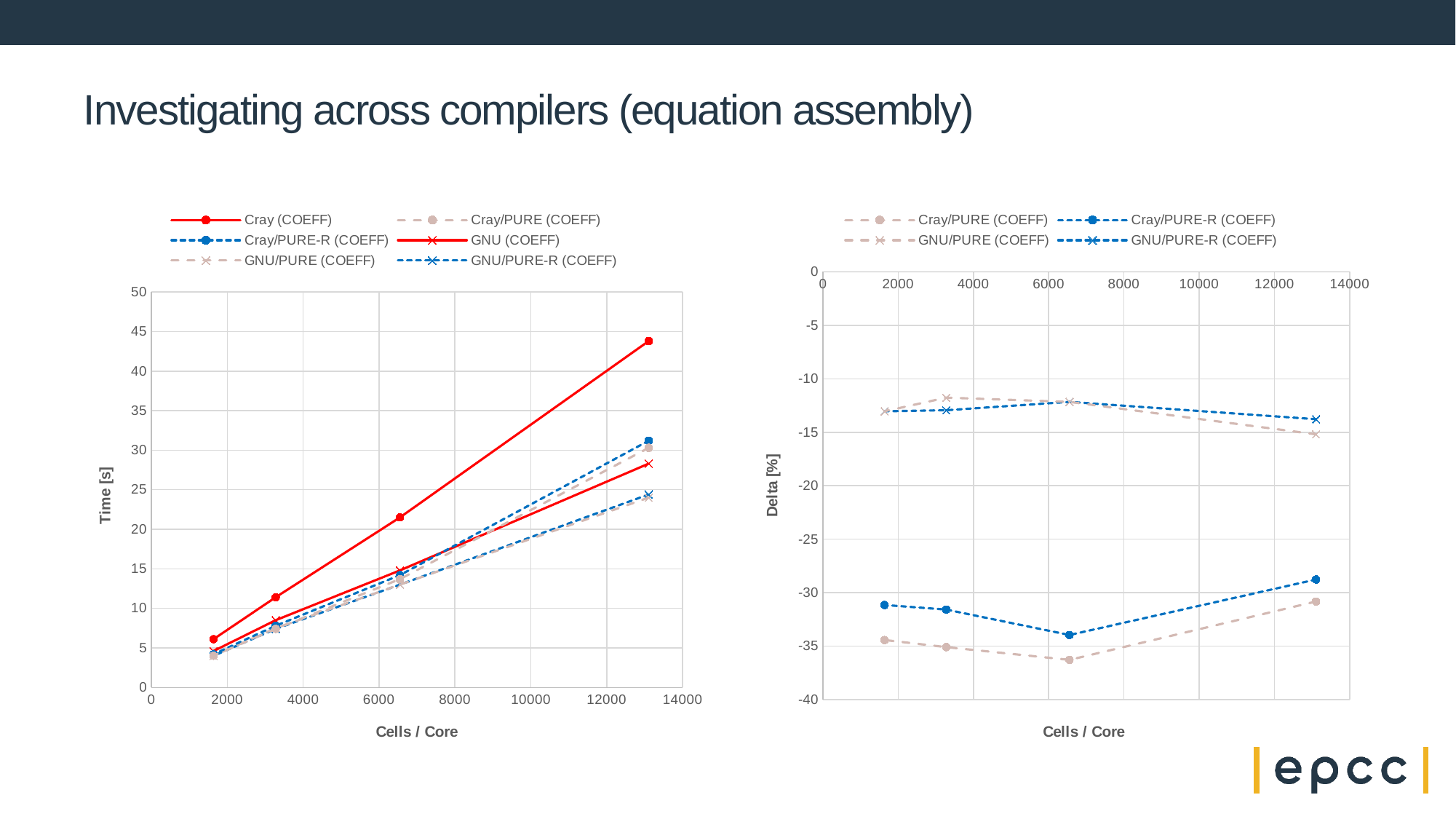
In the left chart, how many data points does the Cray (COEFF) series have? 4 How many series does the legend of the right chart list? 4 In the right chart, is the Delta [%] for Cray/PURE-R (COEFF) at the largest Cells / Core value greater or less than -30? greater What is the y-axis label of the right chart? Delta [%] In the left chart, which series has the highest time at the largest Cells / Core value? Cray (COEFF) In the left chart, is the time for GNU (COEFF) at the largest Cells / Core value greater or less than 30? less How many series does the legend of the left chart list? 6 What kind of chart is the left chart on the slide? line chart In the left chart, is the time for Cray (COEFF) at the largest Cells / Core value greater or less than 40? greater In the right chart, which series has the lowest Delta [%] values? Cray/PURE (COEFF) In the left chart, does the time for Cray (COEFF) rise or fall as Cells / Core increases? rise In the left chart, which is larger at the largest Cells / Core value: Cray (COEFF) or GNU (COEFF)? Cray (COEFF)